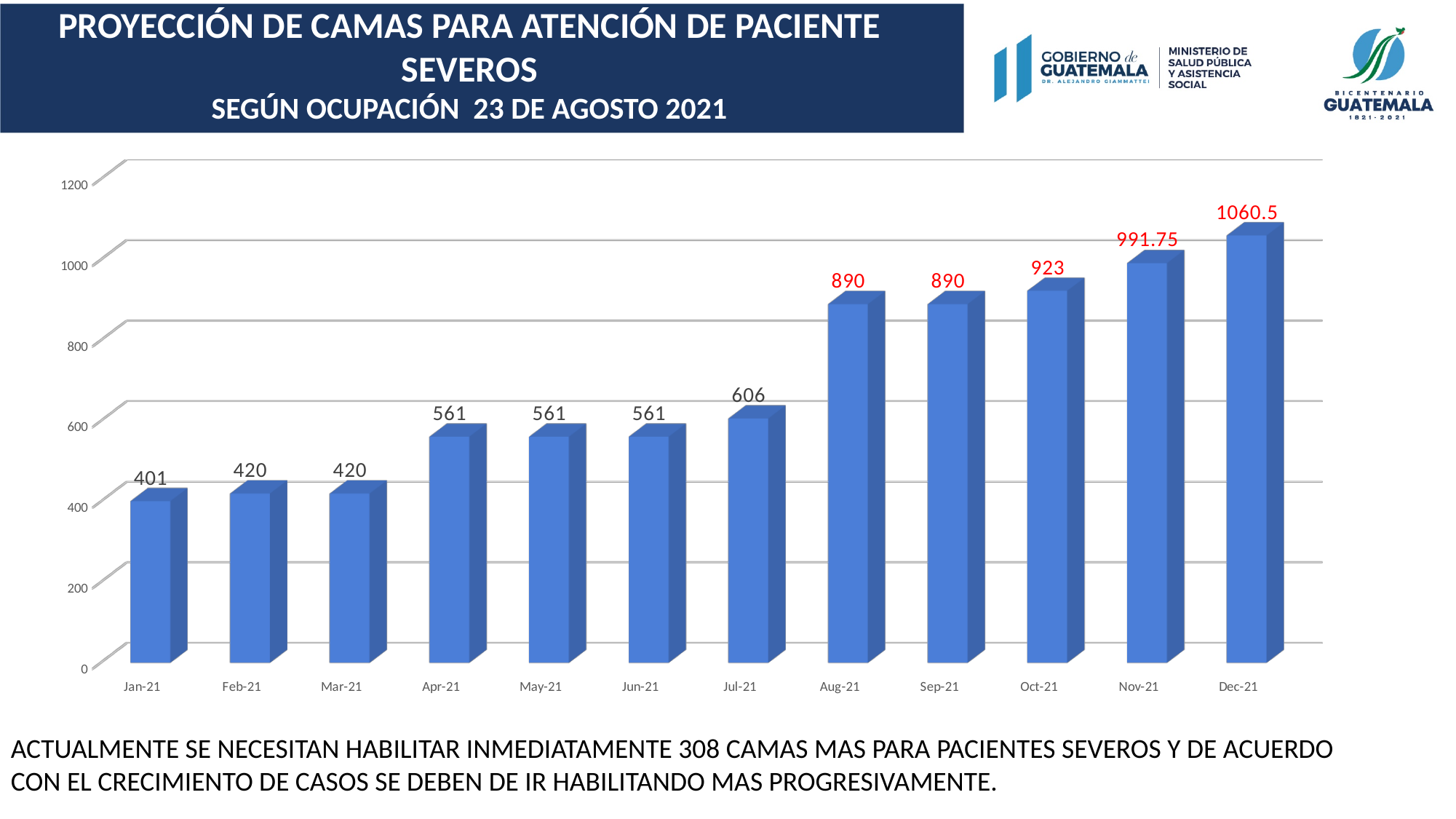
What is the value for Jan-21? 401 What is the value for Jul-21? 606 What is the difference between the values for Aug-21 and Jul-21? 284 What is the difference between the values for Oct-21 and Sep-21? 33 What is the value for Nov-21? 991.75 Which is larger, the value for Apr-21 or the value for Feb-21? Apr-21 What kind of chart is shown on the slide? Bar chart How many months are shown on the x axis? 12 Which month has the lowest value? Jan-21 Do the values generally rise or fall from Jan-21 to Dec-21? Rise Which month has the highest value? Dec-21 What is the value for Dec-21? 1060.5